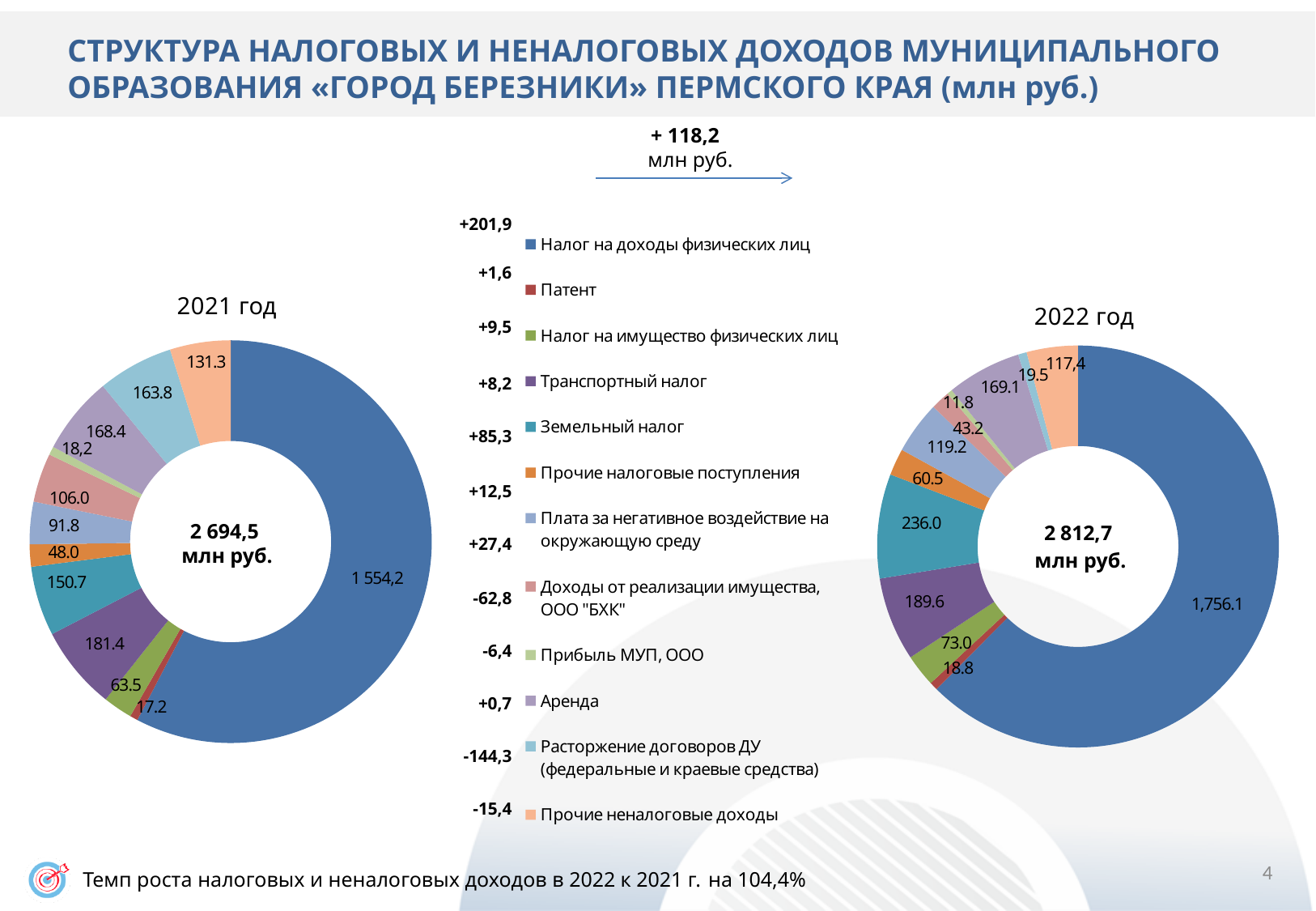
On the 2021 год chart, which category has the smallest value? Патент On the 2022 год chart, which is larger: Земельный налог or Транспортный налог? Земельный налог On the 2021 год chart, what is the value for Аренда? 168.4 On the 2021 год chart, what is the value for Налог на доходы физических лиц? 1 554,2 On the 2022 год chart, which category has the smallest value? Прибыль МУП, ООО On the 2022 год chart, what is the value for Прочие неналоговые доходы? 117,4 What kind of chart is the 2022 год chart? Donut (pie) chart On the 2022 год chart, what is the value for Земельный налог? 236.0 How many categories does the 2021 год chart show? 12 What total is shown in the centre of the 2022 год chart? 2 812,7 млн руб. What is the difference between the Земельный налог value on the 2022 год chart (236.0) and on the 2021 год chart (150.7)? 85.3 On the 2022 год chart, which category has the largest value? Налог на доходы физических лиц